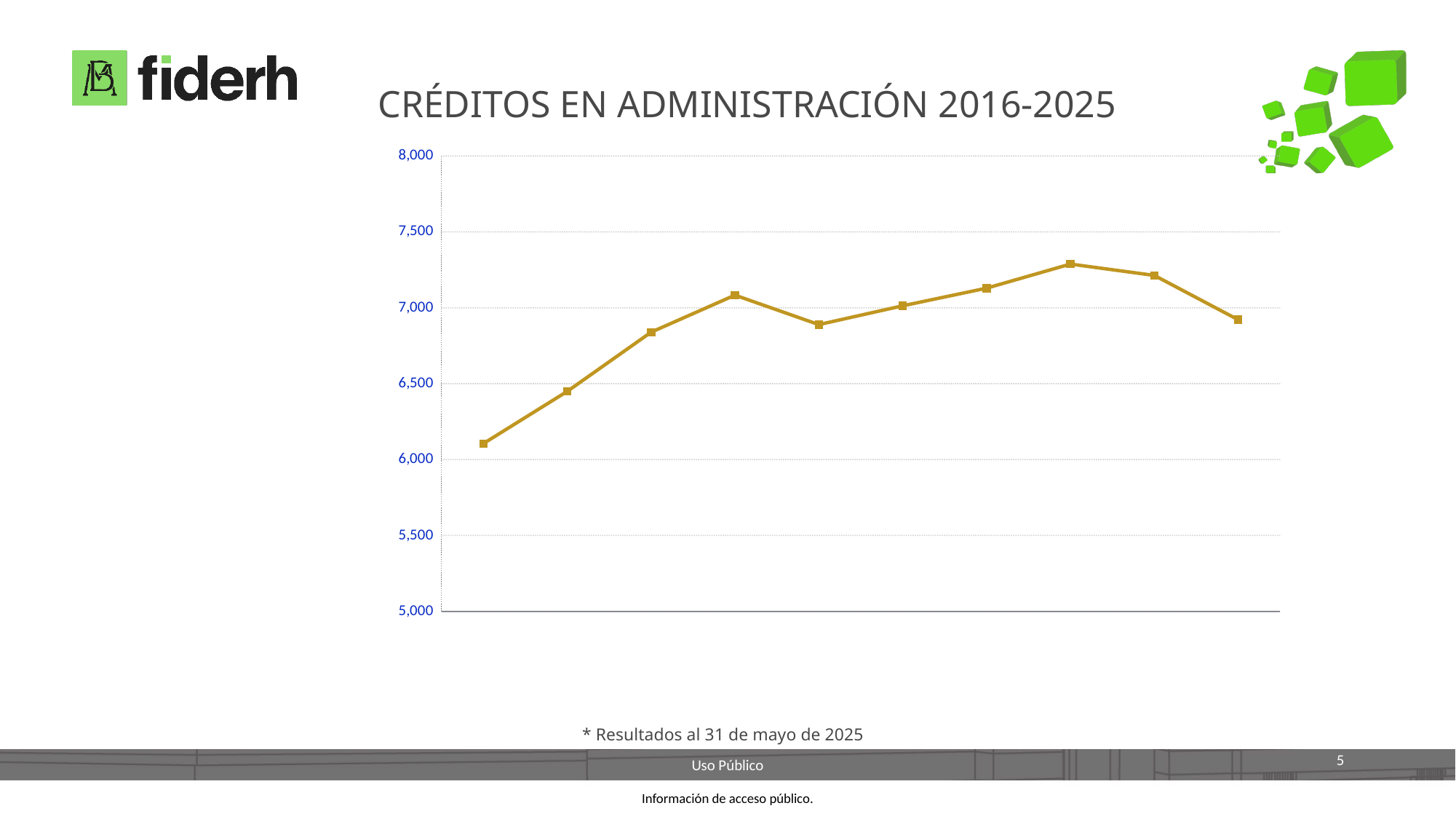
Is the value of the third point on the line greater or less than 7,000? less Does the line end higher or lower than it starts? higher Is the value of the first point on the line greater or less than 6,000? greater What is the highest value shown on the vertical axis? 8,000 Which is larger, the value of the second point or the value of the third point? the third point How many data points are plotted on the line? 10 What kind of chart is shown on the slide? line chart Is the value of the highest point on the line greater or less than 7,500? less What is the title of the chart? CRÉDITOS EN ADMINISTRACIÓN 2016-2025 Which point on the line has the lowest value? the first point Which point on the line has the highest value? the eighth point